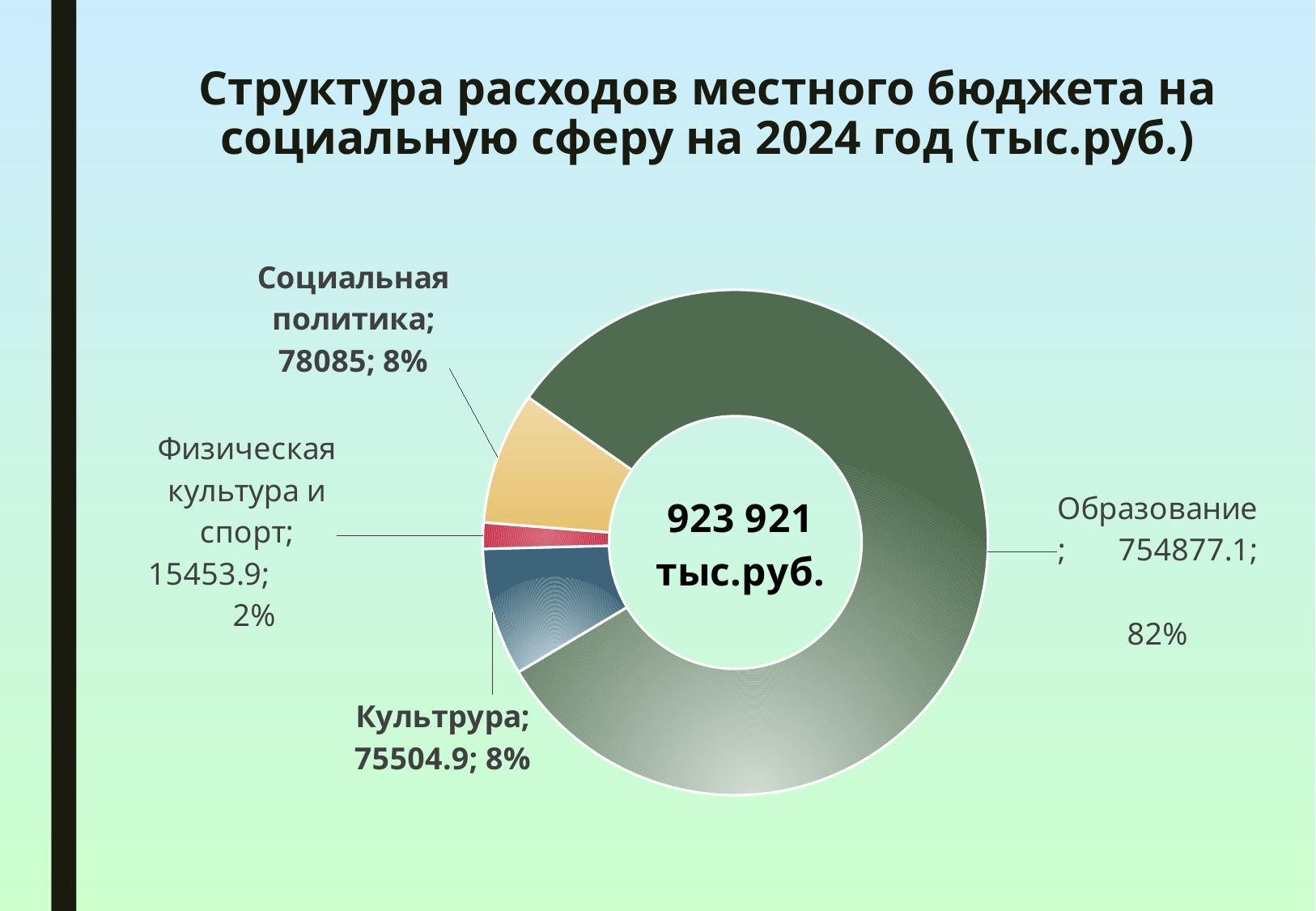
What total is shown in the centre of the chart? 923 921 тыс.руб. What share of the chart does Физическая культура и спорт represent? 2% How many categories are shown in the chart? 4 Which category has the lowest value? Физическая культура и спорт Which is larger, the value for Социальная политика or the value for Культрура? Социальная политика Which category has the highest value? Образование What is the difference between the values for Образование and Социальная политика? 676792.1 What share of the chart does Образование represent? 82% What is the value for Социальная политика? 78085 What is the value for Физическая культура и спорт? 15453.9 What is the value for Образование? 754877.1 What kind of chart is shown on the slide? Doughnut (pie) chart